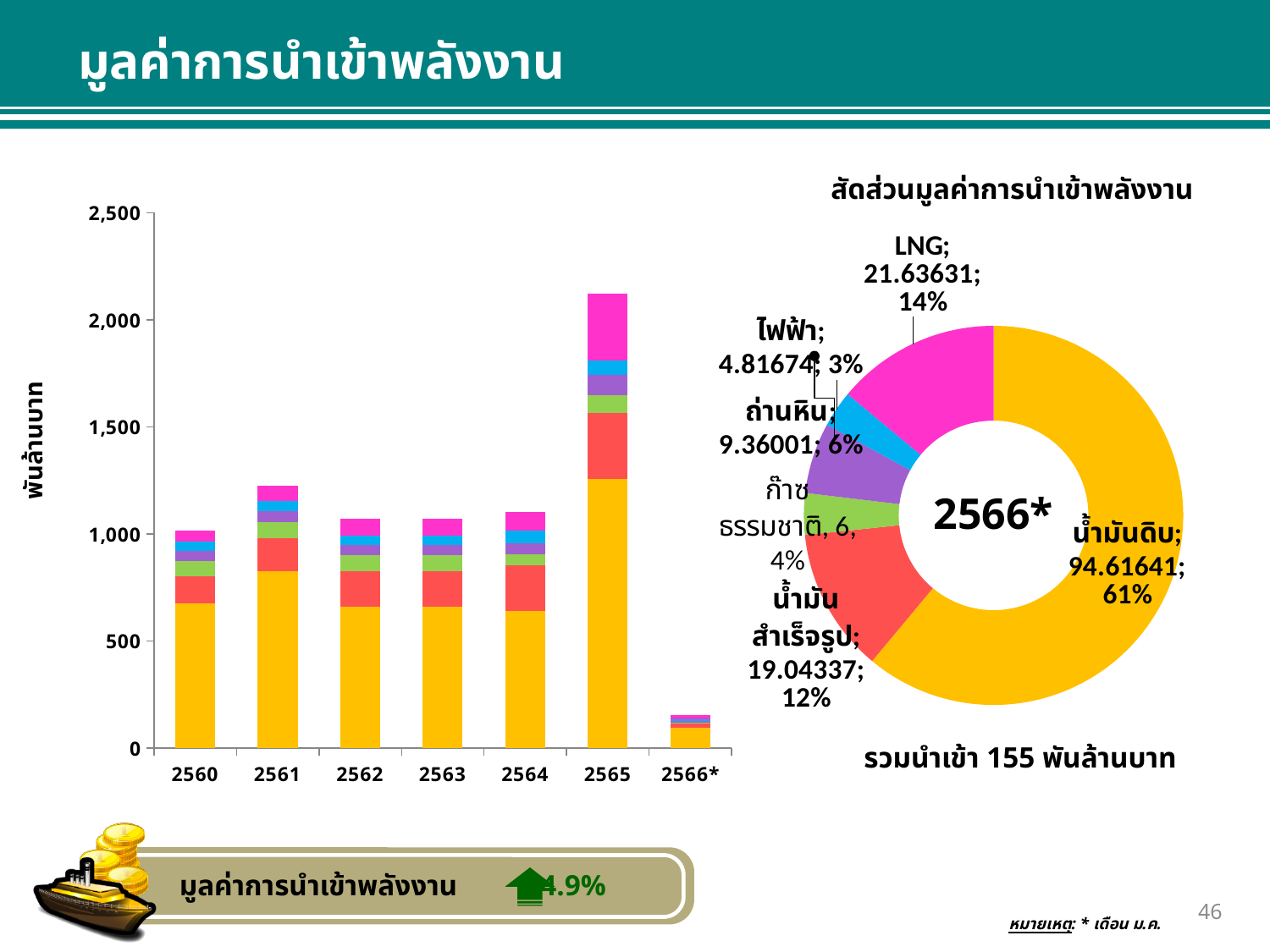
In the doughnut chart สัดส่วนมูลค่าการนำเข้าพลังงาน, what share does น้ำมันดิบ have? 61% In the bar chart on the left, is the total for 2565 greater or less than 2,000? greater In the doughnut chart สัดส่วนมูลค่าการนำเข้าพลังงาน, which category has the smallest share? ไฟฟ้า In the doughnut chart สัดส่วนมูลค่าการนำเข้าพลังงาน, what is the value for LNG? 21.63631 In the bar chart on the left, is the total for 2566* greater or less than 500? less In the bar chart on the left, is the total for 2561 greater or less than 1,000? greater In the bar chart on the left, how many years are shown on the x axis? 7 What kind of chart is the chart titled สัดส่วนมูลค่าการนำเข้าพลังงาน? doughnut chart In the bar chart on the left, which year has the shortest stacked bar? 2566* In the bar chart on the left, which year has the tallest stacked bar? 2565 What kind of chart is the chart on the left of the slide? stacked bar chart In the doughnut chart สัดส่วนมูลค่าการนำเข้าพลังงาน, which is larger, ถ่านหิน or น้ำมันสำเร็จรูป? น้ำมันสำเร็จรูป